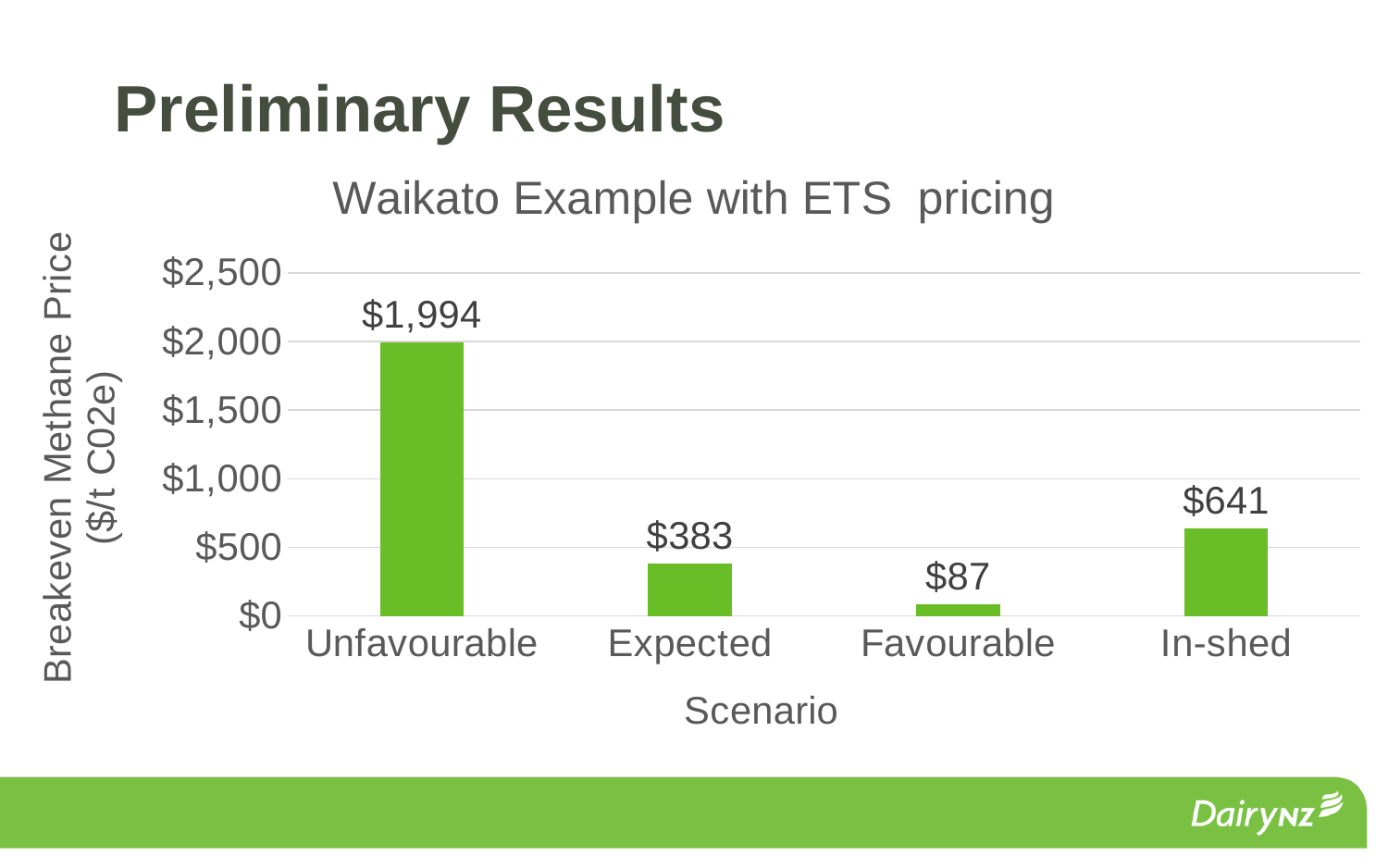
What type of chart is shown on the slide? Bar chart Which scenario has the lowest breakeven methane price? Favourable What is the breakeven methane price for the In-shed scenario? $641 What is the breakeven methane price for the Unfavourable scenario? $1,994 What is the breakeven methane price for the Favourable scenario? $87 What is the breakeven methane price for the Expected scenario? $383 What is the difference between the breakeven methane price for the Unfavourable scenario and the Expected scenario? $1,611 Which has a higher breakeven methane price, the In-shed scenario or the Expected scenario? In-shed Is the value for the Expected scenario greater or less than $500? less How many scenarios are shown on the chart? 4 Which scenario has the highest breakeven methane price? Unfavourable What is the difference between the breakeven methane price for the In-shed scenario and the Favourable scenario? $554